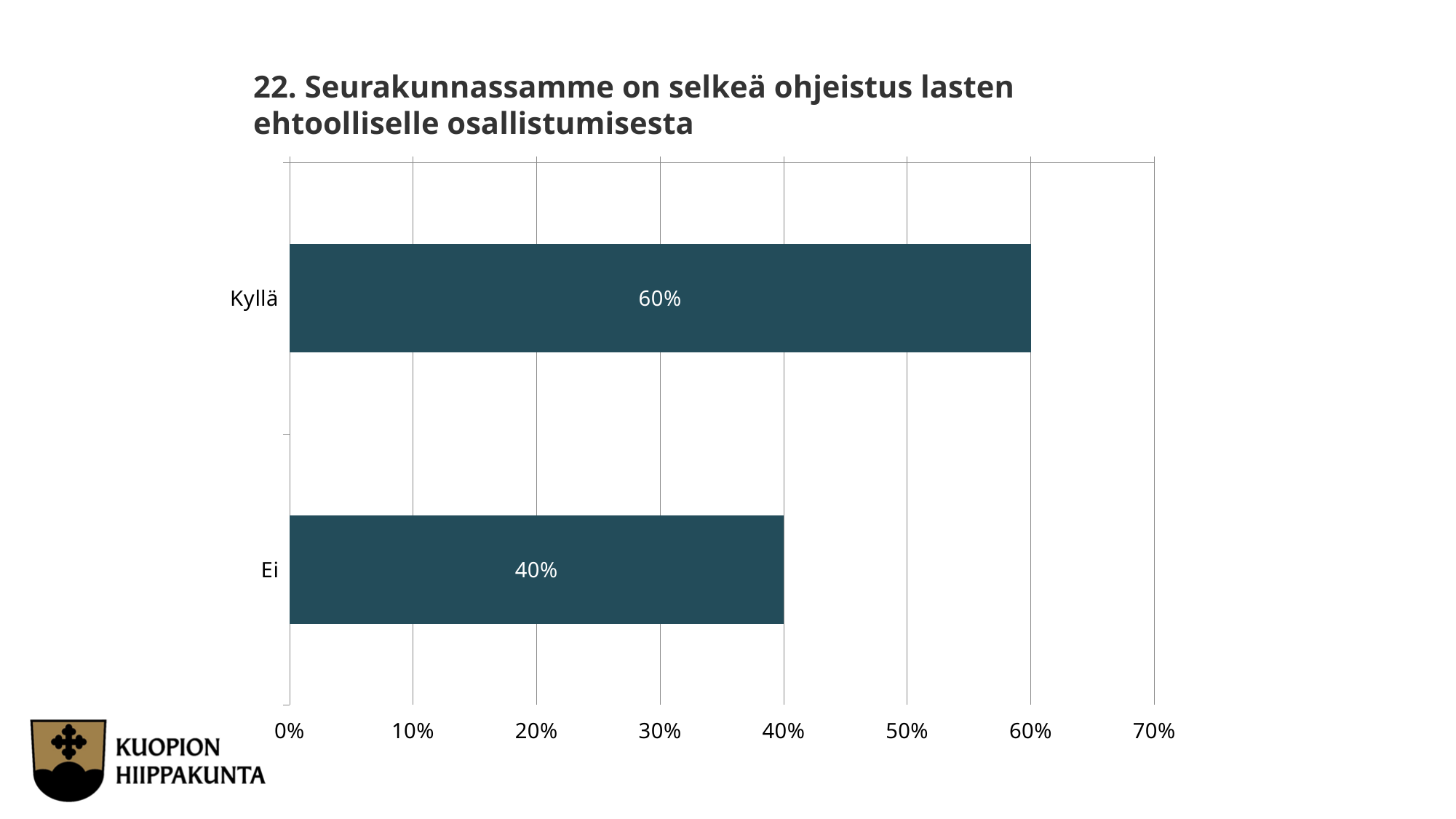
Is the value for Kyllä greater or less than 50%? greater What is the difference between the values for Kyllä and Ei? 20% Which category has the highest value? Kyllä What is the highest value shown on the x axis? 70% Which is larger, the value for Kyllä or the value for Ei? Kyllä Is the value for Ei greater or less than 50%? less Which category has the lowest value? Ei What is the value for Ei? 40% What is the value for Kyllä? 60% How many categories are shown in the chart? 2 What kind of chart is shown on the slide? bar chart What is the title of the chart? 22. Seurakunnassamme on selkeä ohjeistus lasten ehtoolliselle osallistumisesta